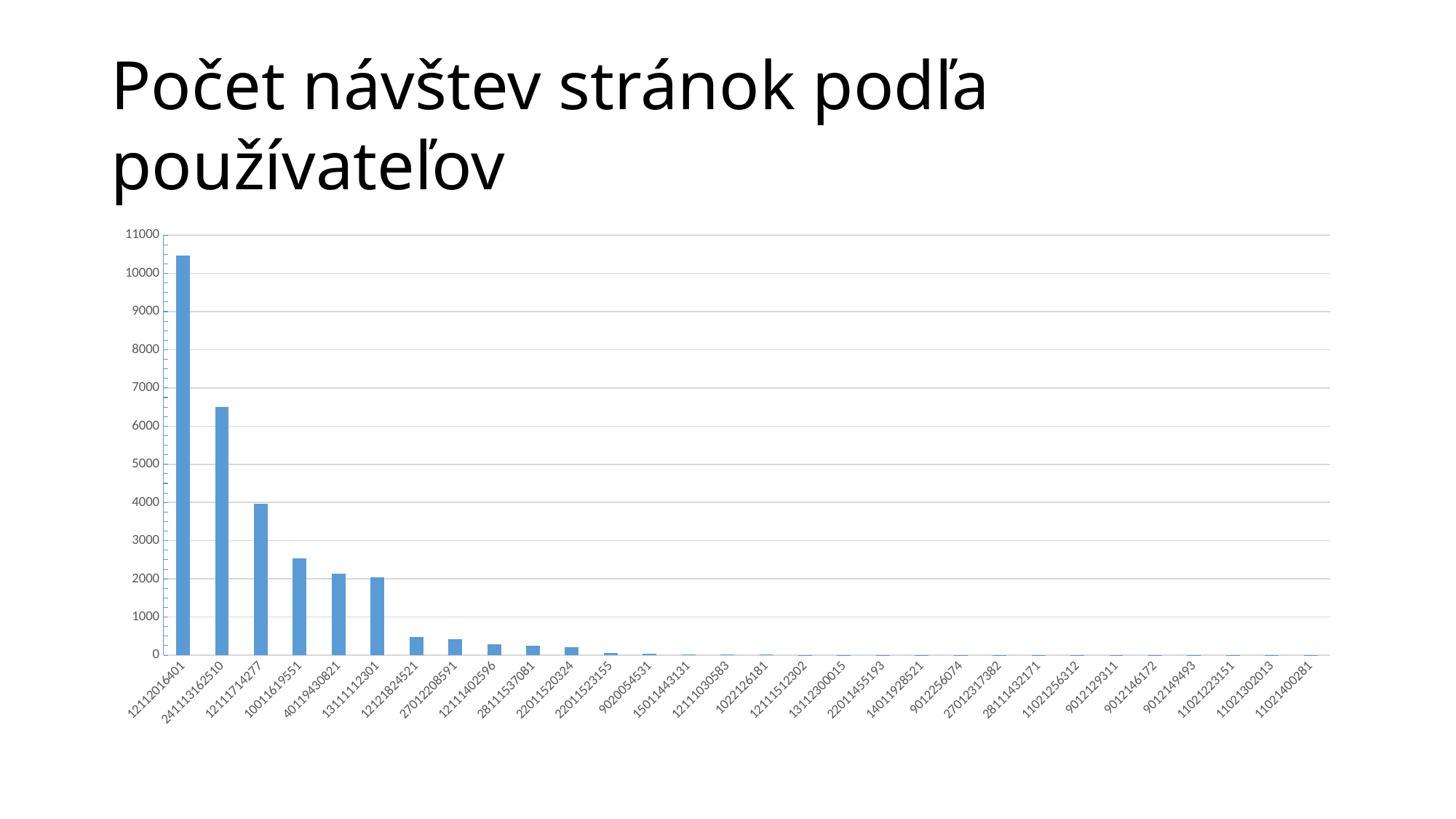
Do the values rise or fall from left to right along the x axis? fall What kind of chart is shown on the slide? bar chart Which is larger, the value for 12111714277 or the value for 10011619551? 12111714277 Which category has the highest bar? 12112016401 How many categories are plotted on the x axis? 30 Is the value for 12121824521 greater or less than 1000? less Which is larger, the value for 12112016401 or the value for 241113162510? 12112016401 Is the value for 40119430821 greater or less than 3000? less Is the value for 12112016401 greater or less than 10000? greater